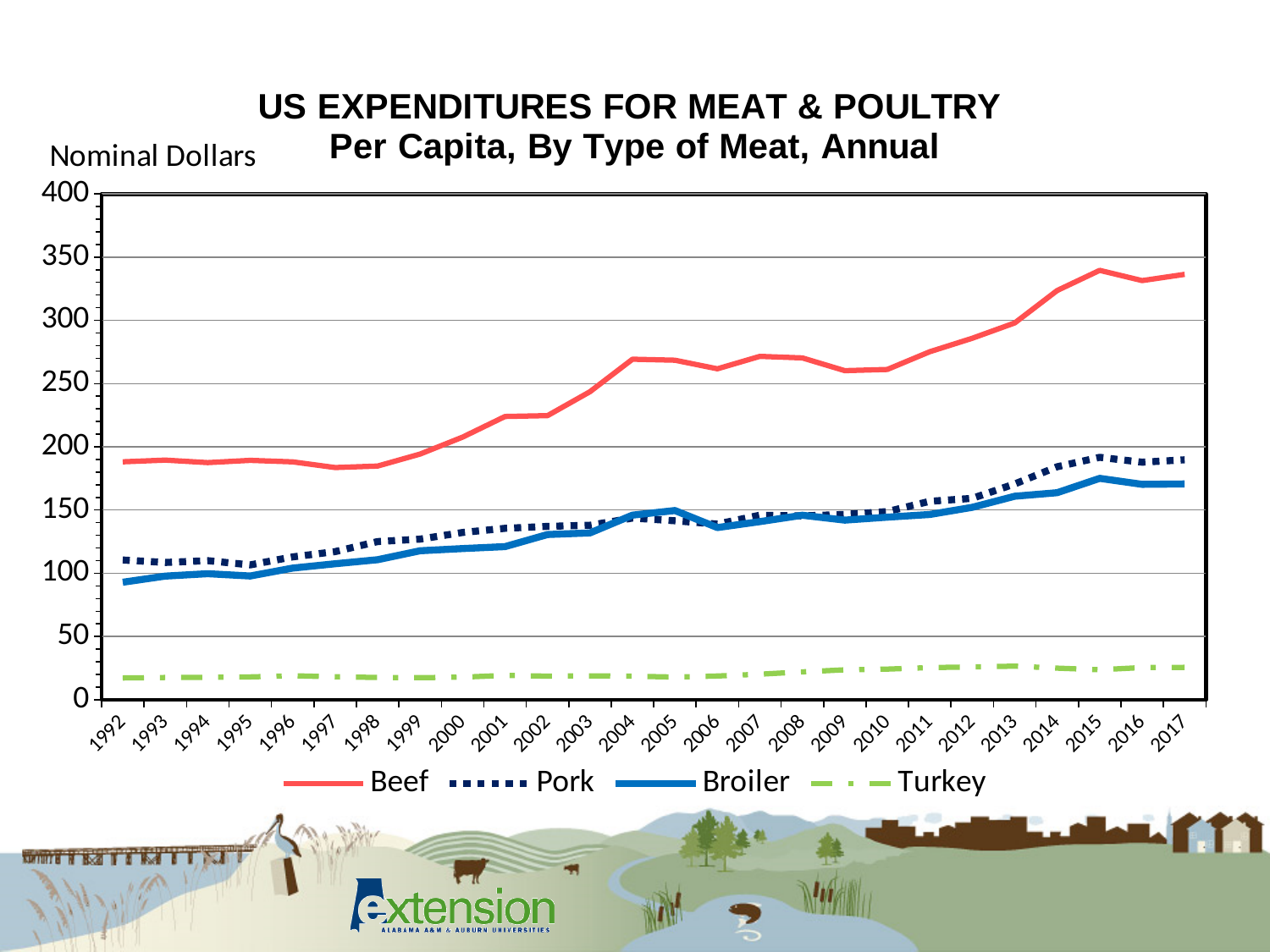
Is the value for Pork in 2017 greater or less than 150? greater Is the value for Beef in 2015 greater or less than 300? greater Is the value for Turkey in 2017 greater or less than 50? less How many years are plotted along the x axis? 26 Which type of meat has the lowest per capita expenditure across the whole period? Turkey Does the Beef line generally rise or fall from 1992 to 2017? rise What kind of chart is shown on the slide? line chart What unit label is shown above the y axis? Nominal Dollars How many series does the legend list? 4 Which type of meat has the highest per capita expenditure in 2017? Beef Which is larger in 2017, the value for Pork or the value for Broiler? Pork